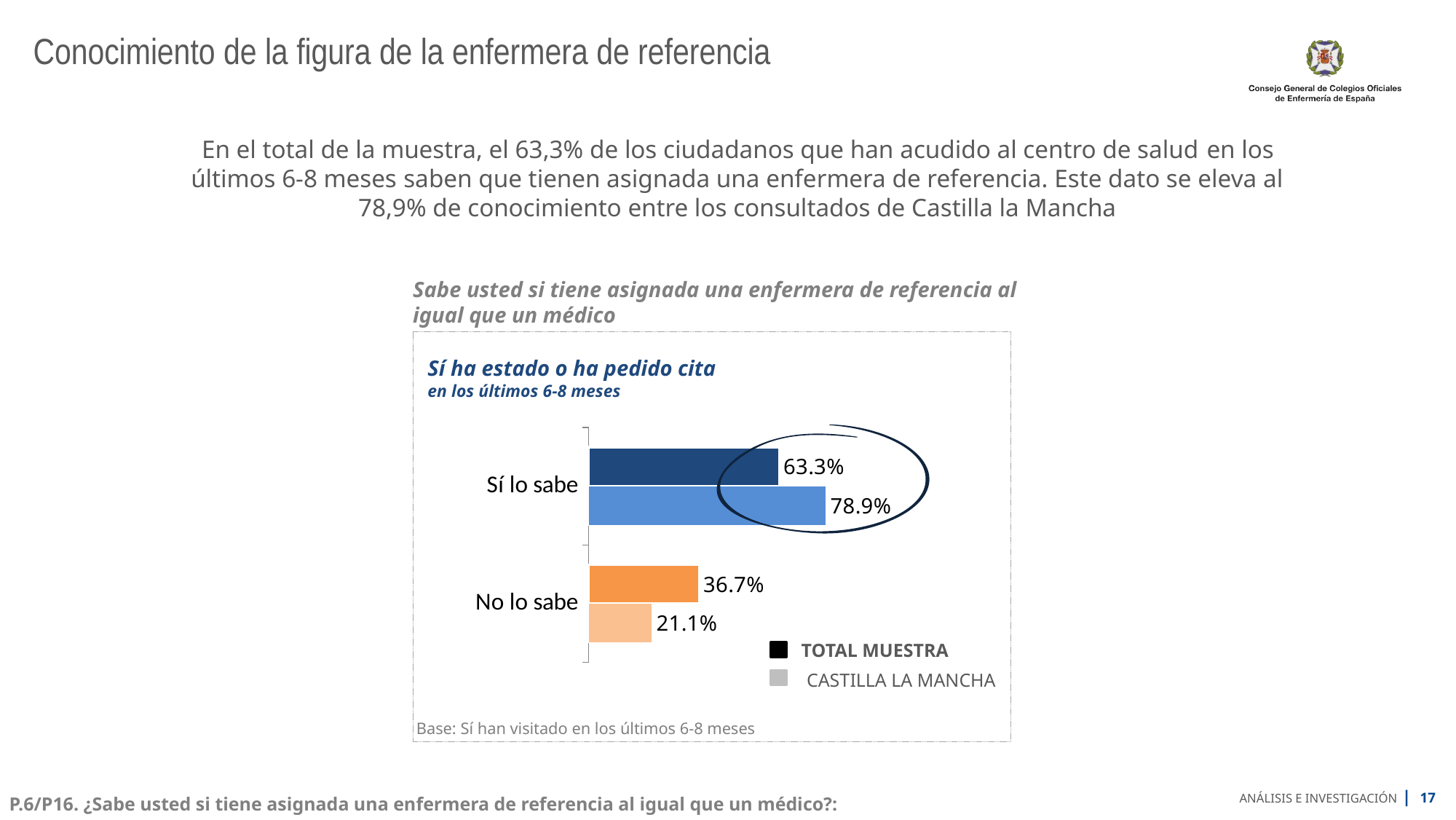
Which category has the highest value in the CASTILLA LA MANCHA series? Sí lo sabe What is the value for 'No lo sabe' in the TOTAL MUESTRA series? 36.7% What is the value for 'Sí lo sabe' in the CASTILLA LA MANCHA series? 78.9% Which category has the lowest value in the TOTAL MUESTRA series? No lo sabe Which is larger for 'No lo sabe': TOTAL MUESTRA or CASTILLA LA MANCHA? TOTAL MUESTRA What is the base noted below the chart? Sí han visitado en los últimos 6-8 meses What is the value for 'Sí lo sabe' in the TOTAL MUESTRA series? 63.3% What is the difference between the CASTILLA LA MANCHA and TOTAL MUESTRA values for 'Sí lo sabe'? 15.6% What kind of chart is shown on the slide? Bar chart What is the value for 'No lo sabe' in the CASTILLA LA MANCHA series? 21.1% How many series does the legend list? 2 How many categories are shown on the chart? 2